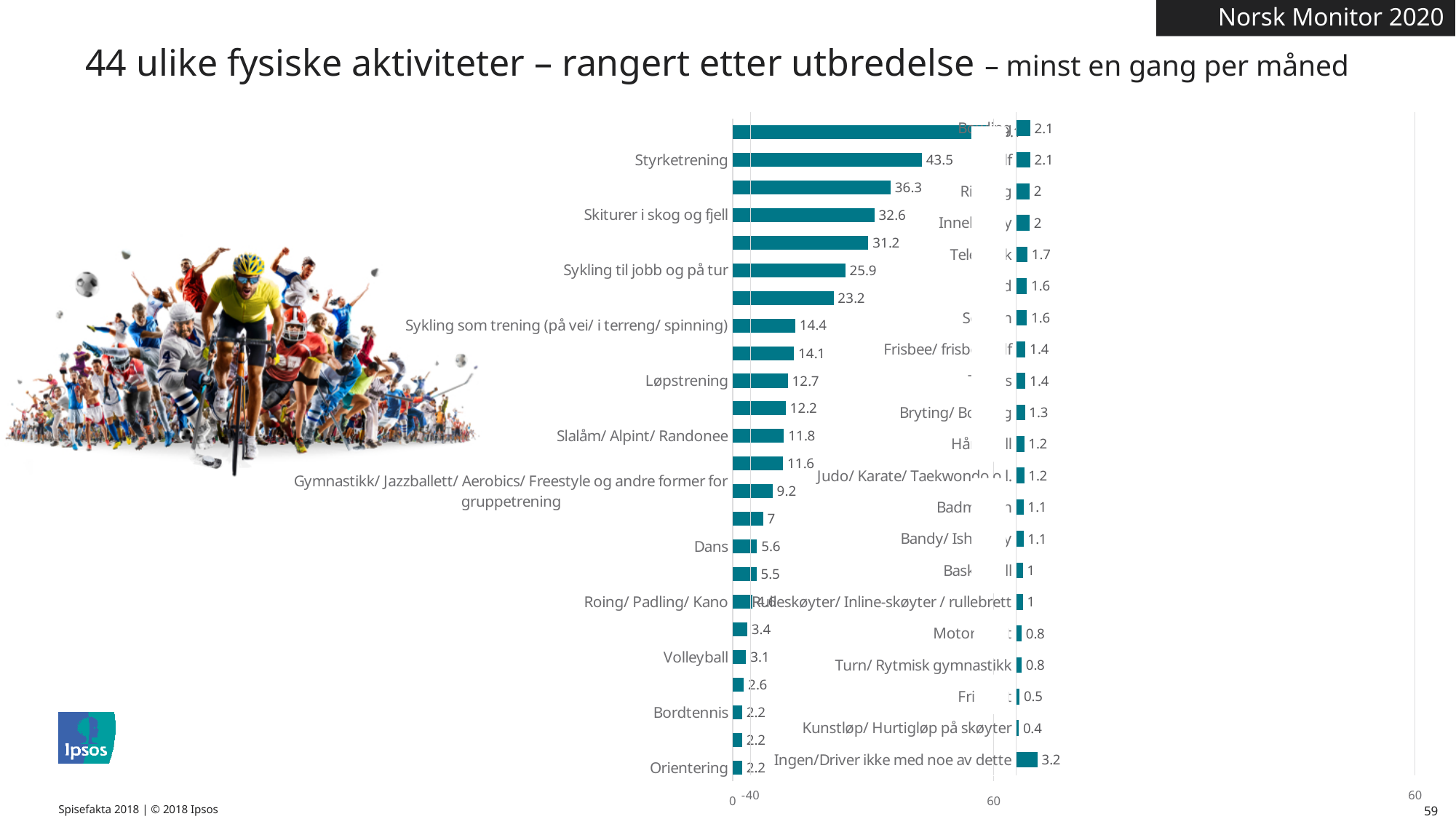
In the left chart, what is the value for Styrketrening? 43.5 In the right chart, what is the value for Kunstløp/ Hurtigløp på skøyter? 0.4 In the left chart, what is the value for Volleyball? 3.1 In the left chart, what is the value for Løpstrening? 12.7 In the left chart, what is the difference between the values for Styrketrening and Skiturer i skog og fjell? 10.9 In the left chart, what is the value for Sykling til jobb og på tur? 25.9 In the right chart, what is the value for Ingen/Driver ikke med noe av dette? 3.2 In the left chart, which is larger: Sykling til jobb og på tur or Løpstrening? Sykling til jobb og på tur In the left chart, what is the value for Skiturer i skog og fjell? 32.6 What kind of chart is shown on the slide? Bar chart In the left chart, what is the value for Slalåm/ Alpint/ Randonee? 11.8 In the left chart, what is the value for Dans? 5.6